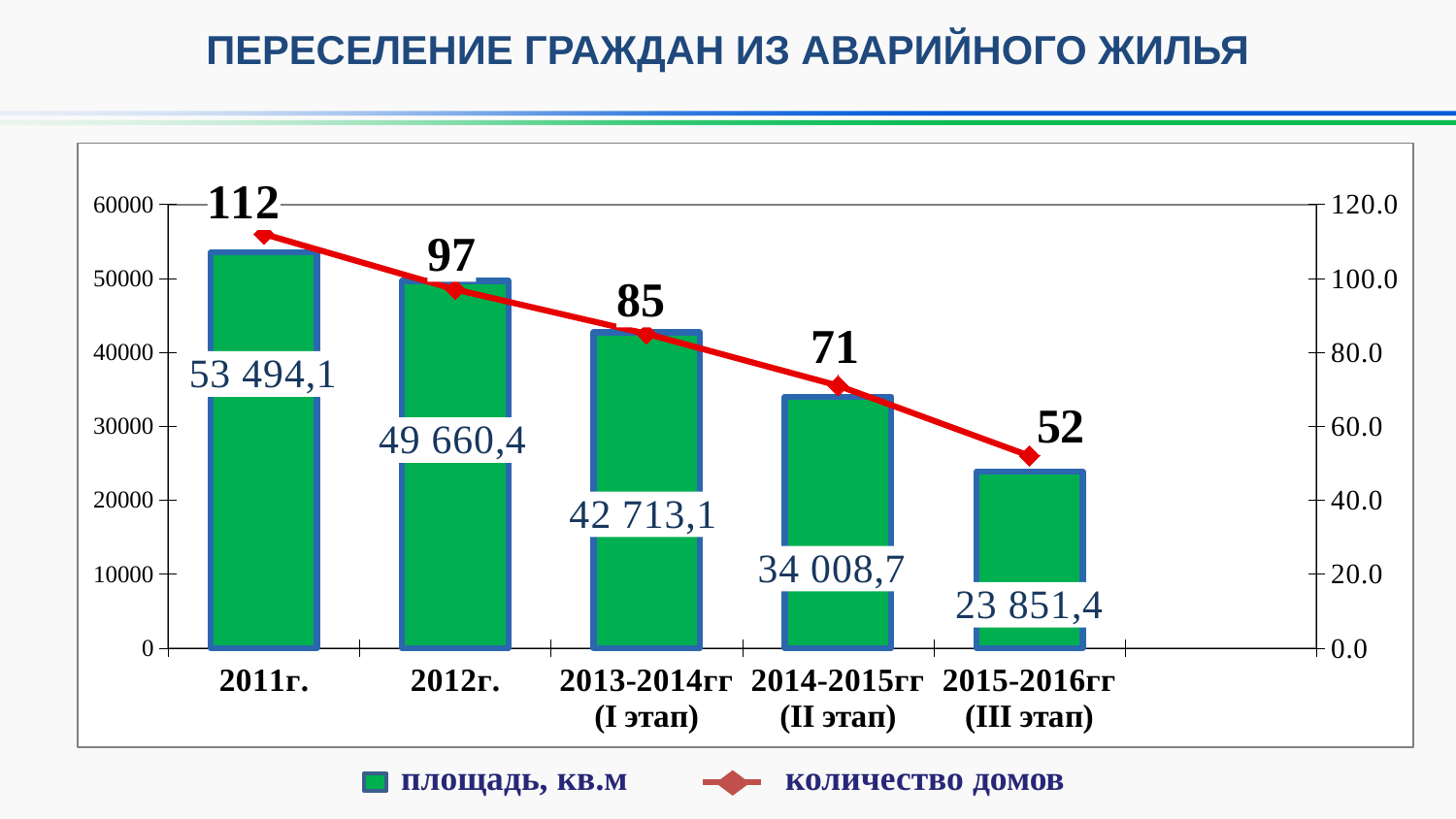
Which period has the highest number of houses (количество домов)? 2011г. Which is larger, the area for 2012г. or the area for 2014-2015гг (II этап)? 2012г. What is the difference in the number of houses between 2011г. and 2012г.? 15 What is the area (площадь, кв.м) for 2015-2016гг (III этап)? 23 851,4 How many periods are shown on the x axis? 5 Do the values for количество домов rise or fall from 2011г. to 2015-2016гг (III этап)? fall How many series does the legend list? 2 What is the number of houses (количество домов) for 2013-2014гг (I этап)? 85 What is the area (площадь, кв.м) for 2011г.? 53 494,1 What kind of chart is this? Combined bar and line chart Is the area for 2014-2015гг (II этап) greater or less than 30000? greater Which period has the lowest area (площадь, кв.м)? 2015-2016гг (III этап)